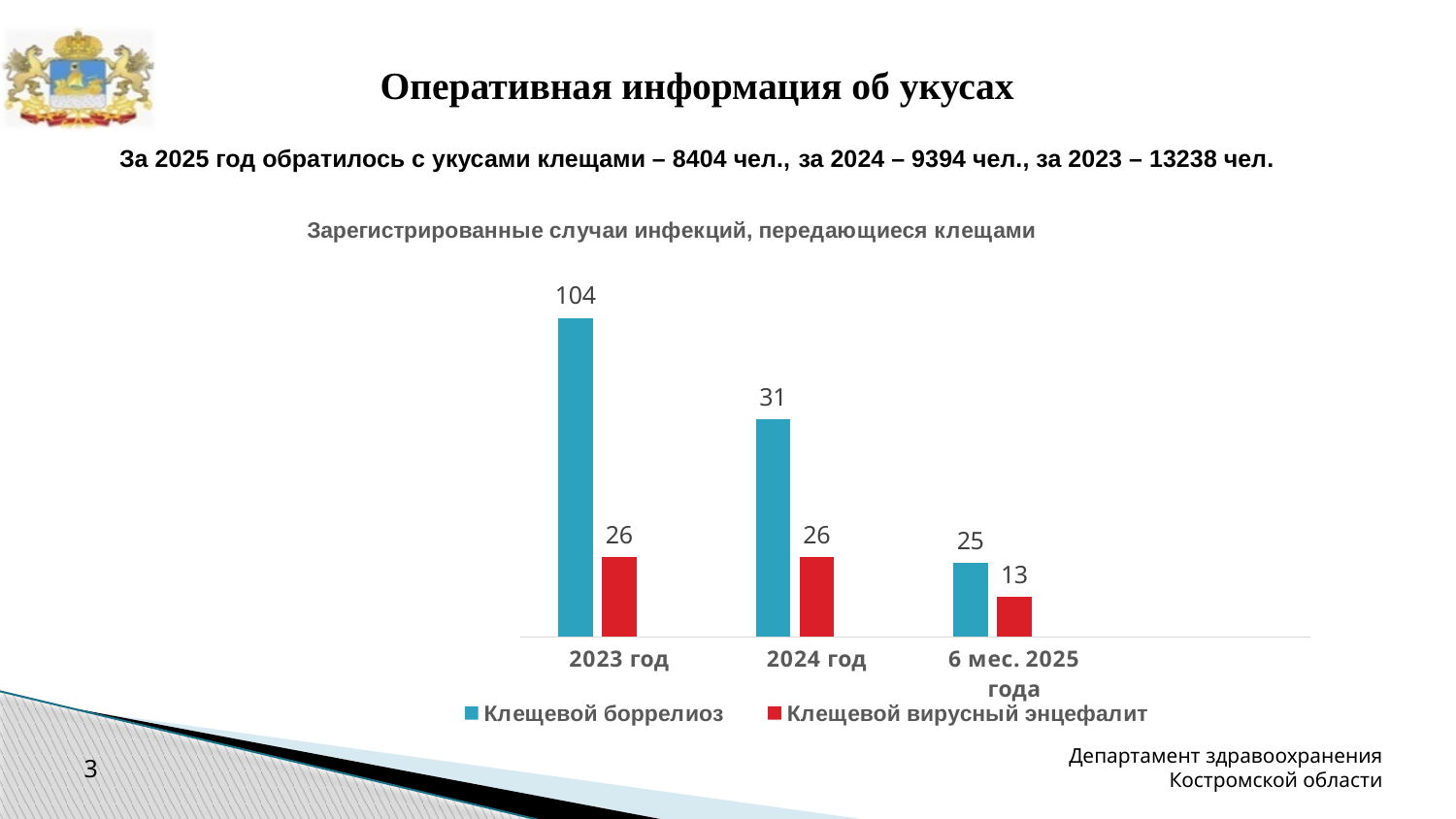
What is the value for Клещевой вирусный энцефалит in 6 мес. 2025 года? 13 How many categories are shown on the x axis? 3 What is the value for Клещевой боррелиоз in 2024 год? 31 Which category has the highest value for Клещевой боррелиоз? 2023 год Do the values for Клещевой боррелиоз rise or fall from 2023 год to 6 мес. 2025 года? fall What is the value for Клещевой боррелиоз in 2023 год? 104 What is the title of the chart? Зарегистрированные случаи инфекций, передающиеся клещами What kind of chart is shown on the slide? bar chart How many series does the legend list? 2 What is the difference between Клещевой боррелиоз in 2023 год and in 2024 год? 73 Which category has the lowest value for Клещевой вирусный энцефалит? 6 мес. 2025 года Which is larger in 6 мес. 2025 года: Клещевой боррелиоз or Клещевой вирусный энцефалит? Клещевой боррелиоз